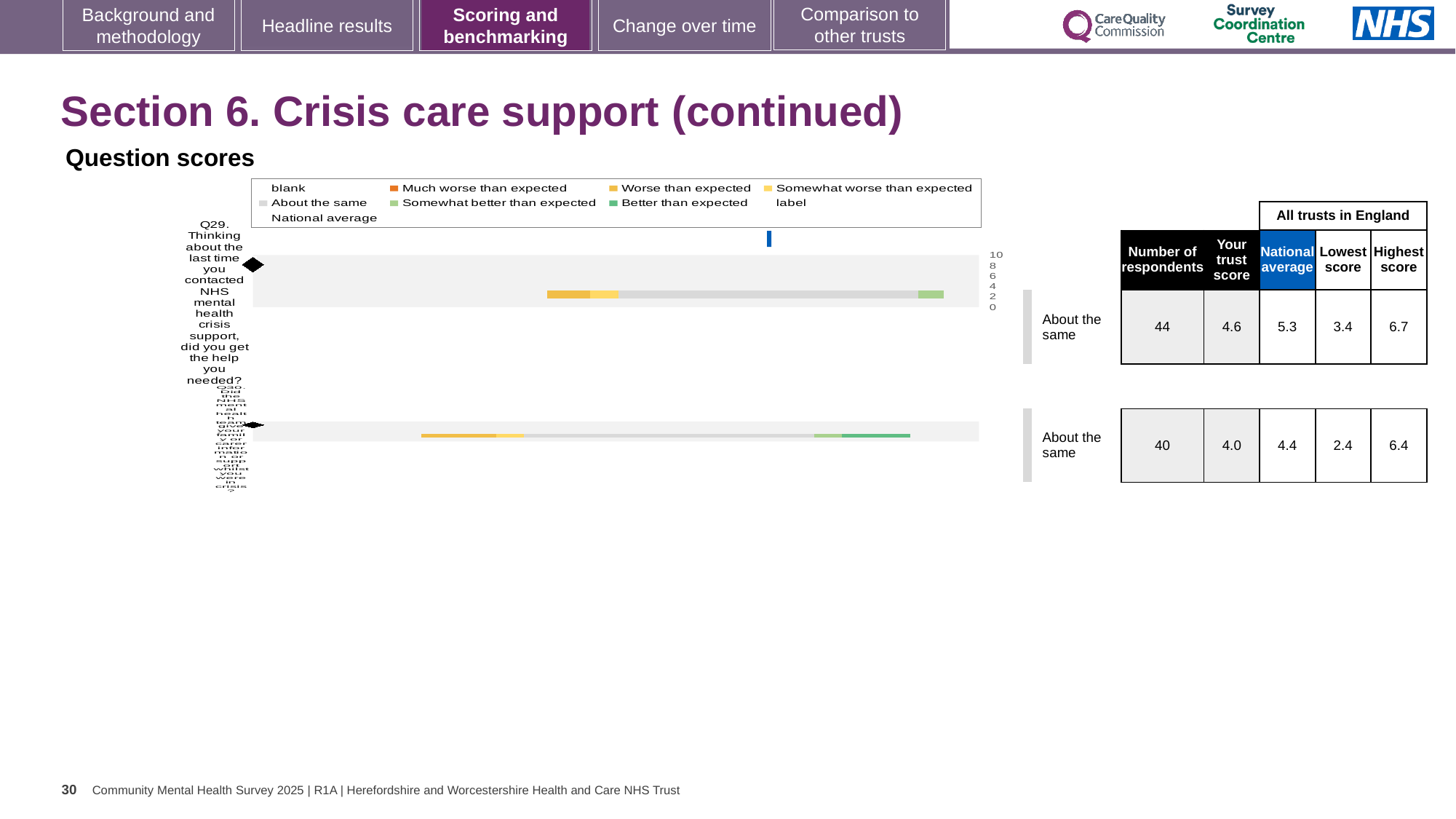
What is the difference between the national average and the trust score for Q29? 0.7 According to the table beside the chart, what is the national average for Q30? 4.4 How many respondents answered Q29? 44 How many questions (rows) are plotted in the chart? 2 What kind of chart is shown under 'Question scores'? Horizontal bar chart What is the highest value shown on the chart's axis? 10 How many entries does the chart legend list? 9 What is the difference between the highest and lowest scores for Q30? 4.0 What benchmark category is shown for both Q29 and Q30? About the same Which question has the higher trust score, Q29 or Q30? Q29 What is the highest score among all trusts in England for Q30? 6.4 According to the table beside the chart, what is the trust score for Q29? 4.6